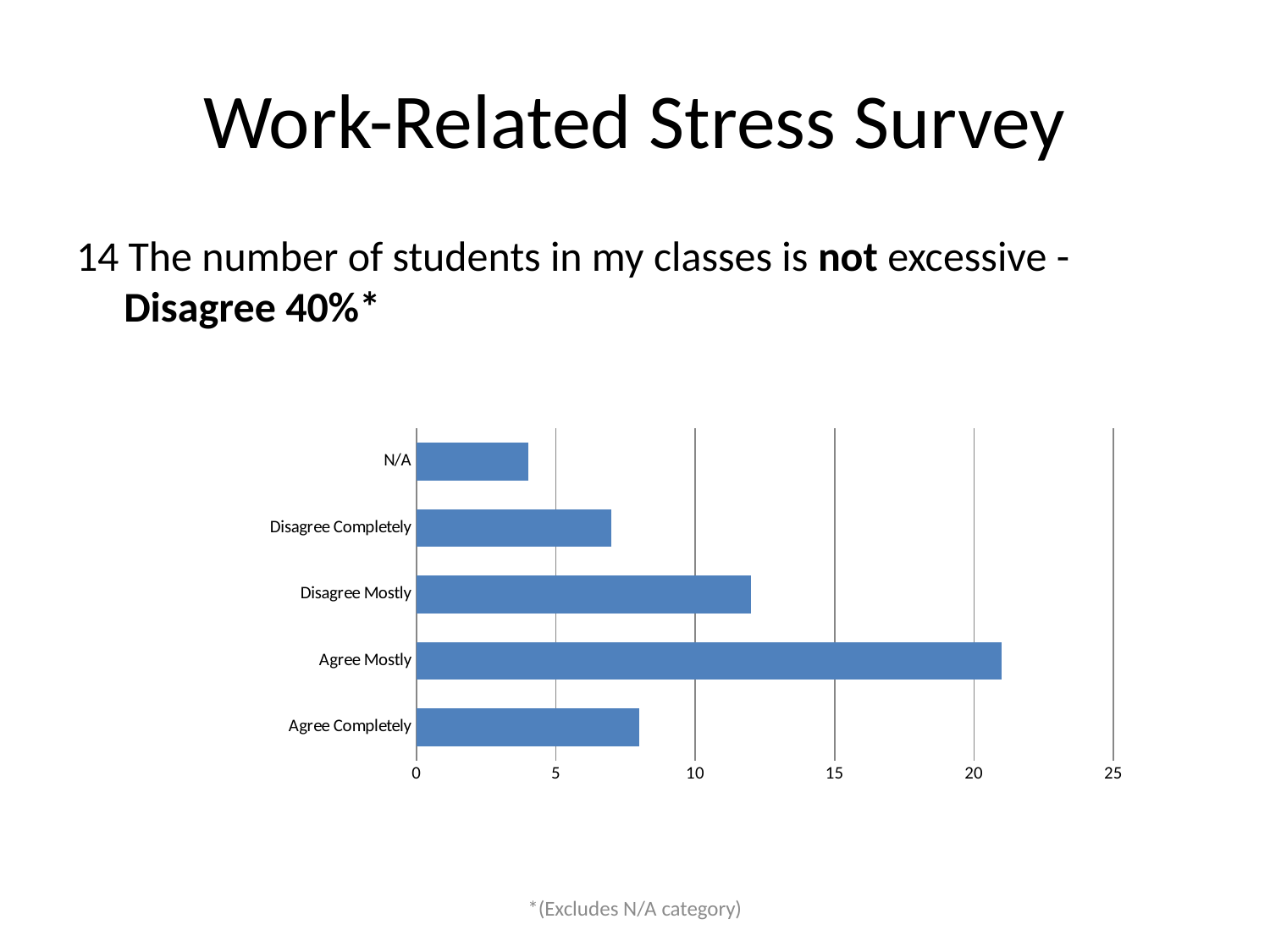
Is the value for Agree Mostly greater or less than 20? greater Is the value for Agree Completely greater or less than 10? less Which is larger, the value for Disagree Mostly or the value for Agree Completely? Disagree Mostly Is the value for N/A greater or less than 5? less Which category has the highest value? Agree Mostly How many categories are plotted on the chart? 5 What is the highest value shown on the horizontal axis of the chart? 25 Which category has the lowest value? N/A Which is larger, the value for Agree Mostly or the value for Disagree Mostly? Agree Mostly What kind of chart is shown on the slide? bar chart